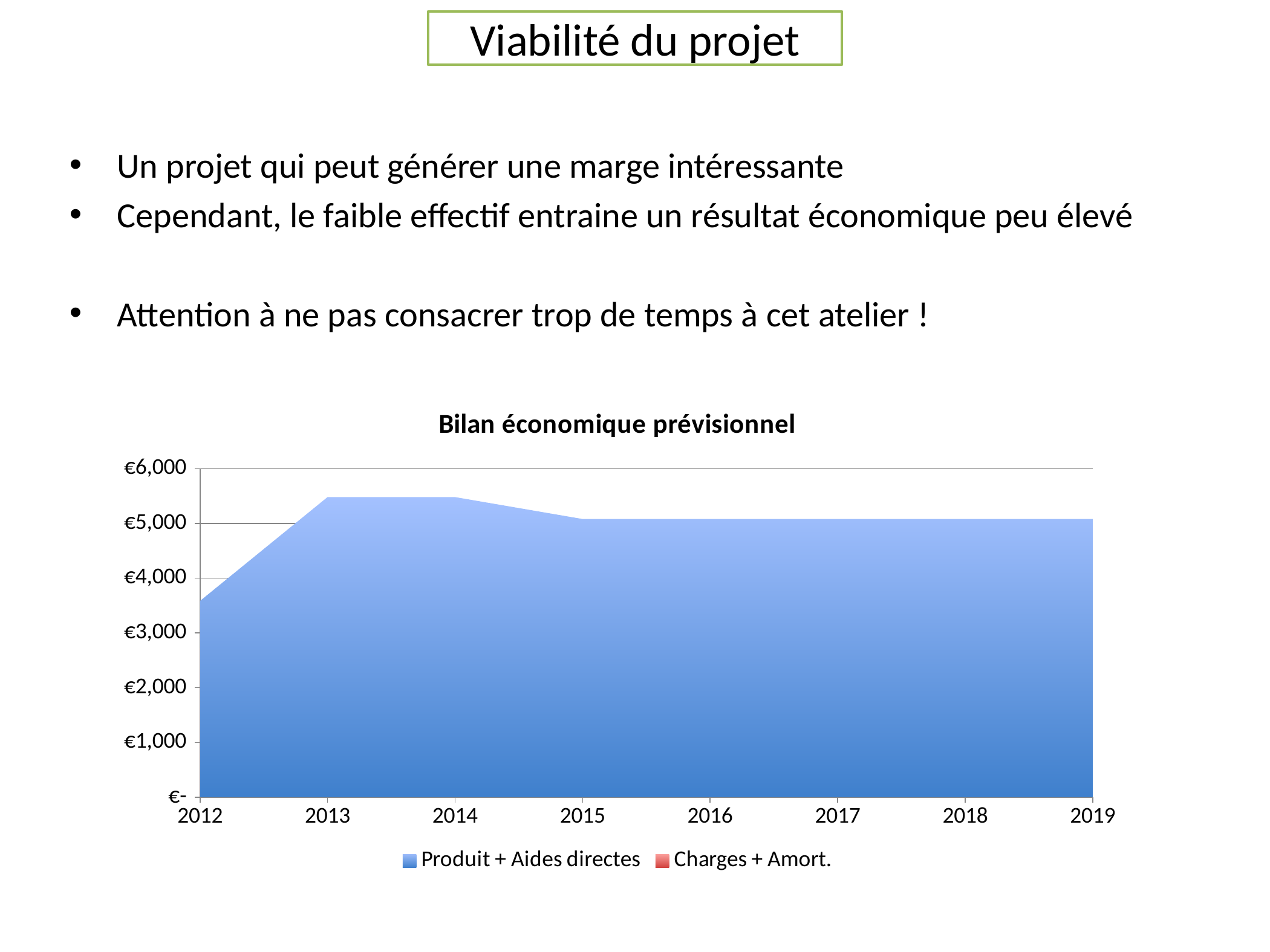
Which year has the larger value for Produit + Aides directes, 2014 or 2015? 2014 How many series does the chart legend list? 2 What is the title of the chart? Bilan économique prévisionnel Is the value for Produit + Aides directes in 2012 greater or less than €3,000? greater Is the value for Produit + Aides directes in 2019 greater or less than €6,000? less What kind of chart is shown on the slide? area chart Is the value for Produit + Aides directes in 2013 greater or less than €5,000? greater Does the value for Produit + Aides directes rise or fall from 2012 to 2013? rise How many years are shown on the x axis of the chart? 8 Which year has the larger value for Produit + Aides directes, 2012 or 2013? 2013 In which year is the value for Produit + Aides directes lowest? 2012